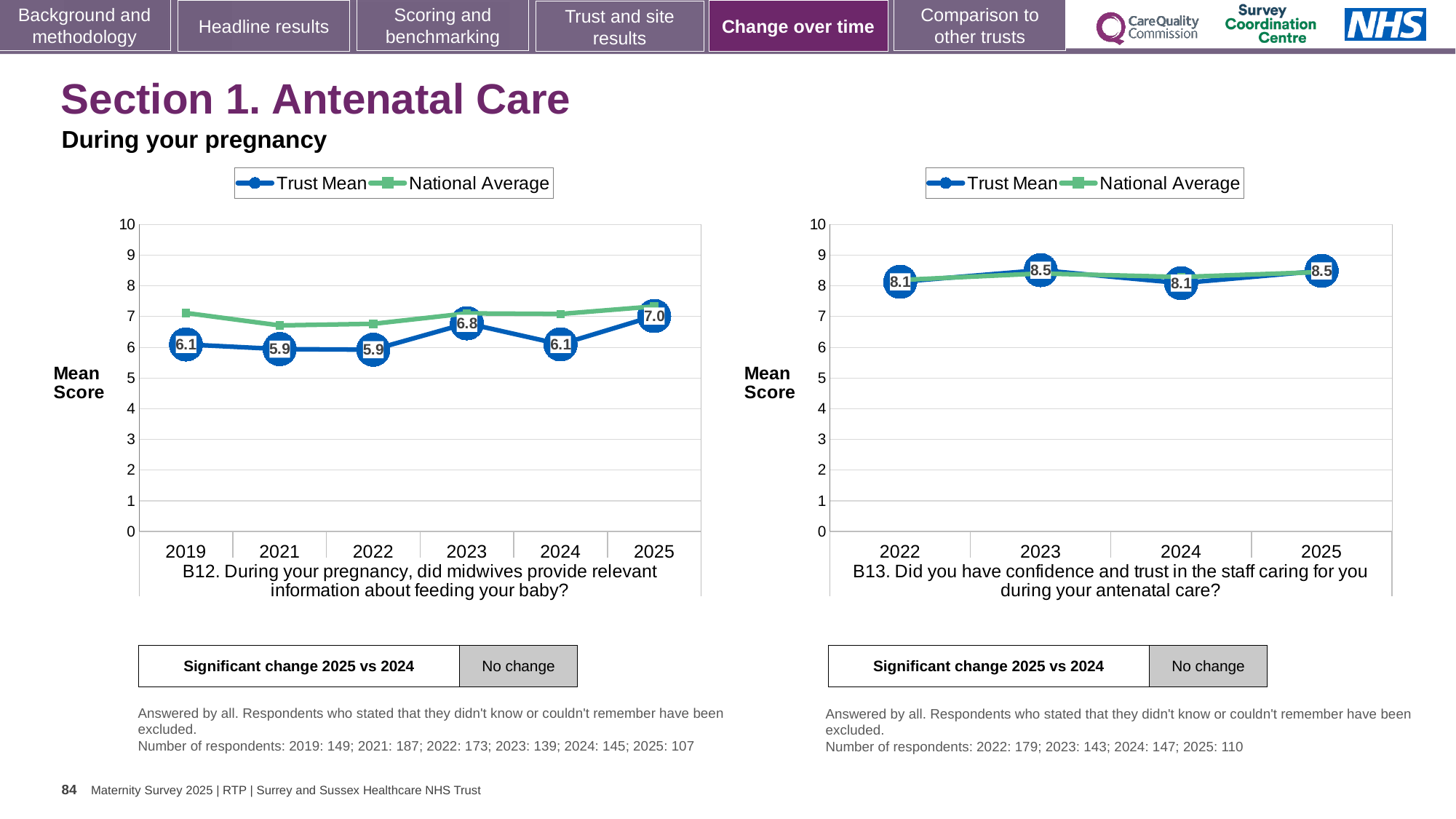
In the B12 chart (left), is the National Average for 2019 greater or less than 6? greater In the B12 chart (left), which year has the highest Trust Mean? 2025 In the B12 chart (left), does the Trust Mean rise or fall from 2024 to 2025? Rise In the B12 chart (left), what is the Trust Mean for 2025? 7.0 In the B13 chart (right), which is larger, the Trust Mean for 2023 or for 2024? 2023 In the B13 chart (right), what is the Trust Mean for 2024? 8.1 What type of chart is the B13 chart (right)? Line chart In the B12 chart (left), what is the Trust Mean for 2023? 6.8 In the B12 chart (left), how many years are plotted on the x axis? 6 In the B13 chart (right), what is the difference between the Trust Mean in 2023 and in 2022? 0.4 In the B12 chart (left), what is the difference between the Trust Mean in 2025 and in 2024? 0.9 In the B13 chart (right), how many series does the legend list? 2